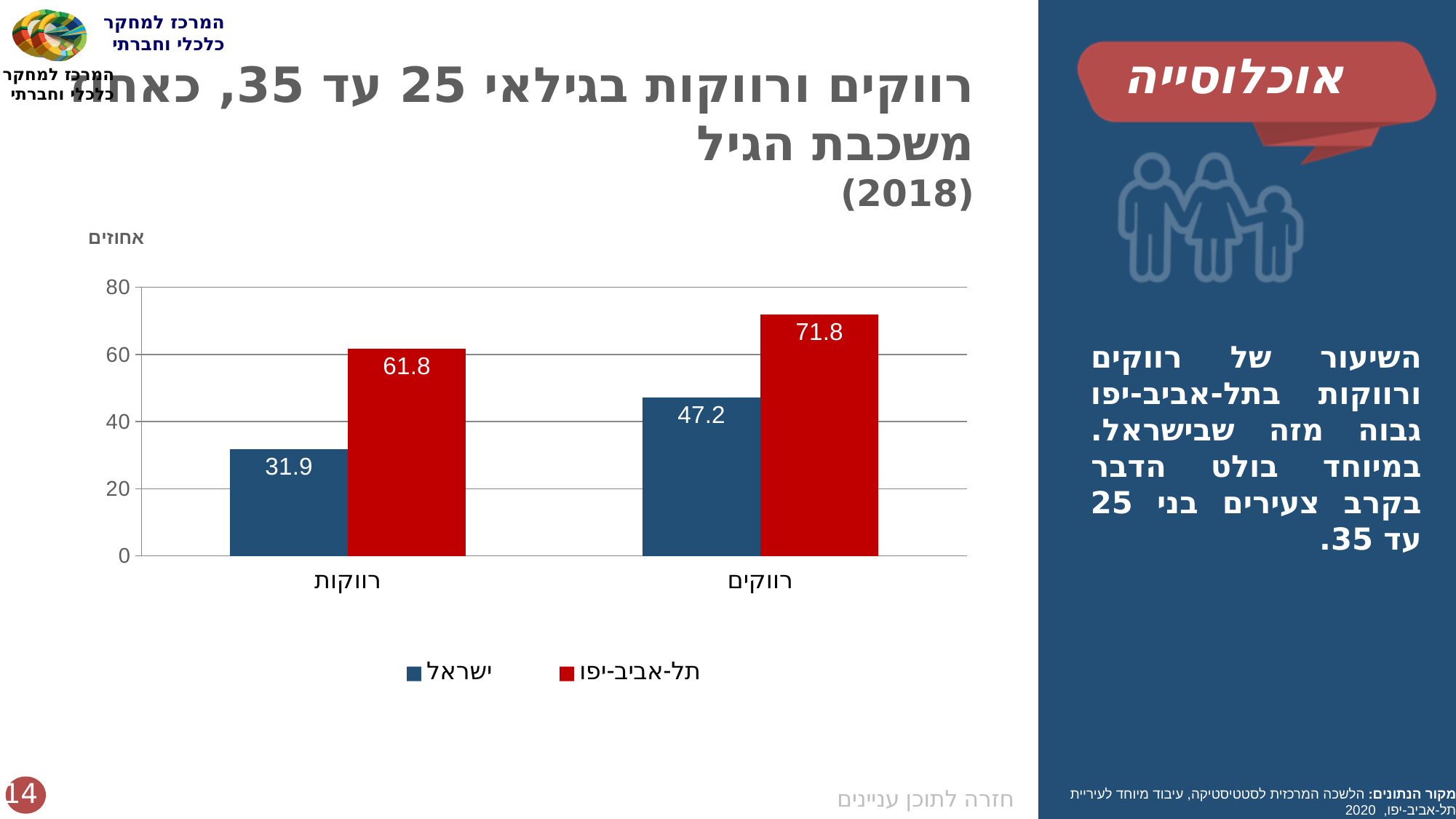
What kind of chart is shown on the slide? Bar chart How many series does the legend list? 2 What is the value for ישראל in the רווקות category? 31.9 What is the difference between the תל-אביב-יפו and ישראל values in the רווקים category? 24.6 Which is larger: the ישראל value for רווקים or the תל-אביב-יפו value for רווקות? תל-אביב-יפו value for רווקות What is the difference between the תל-אביב-יפו and ישראל values in the רווקות category? 29.9 Which bar has the lowest value on the chart? ישראל, רווקות What is the value for תל-אביב-יפו in the רווקות category? 61.8 What is the value for תל-אביב-יפו in the רווקים category? 71.8 How many categories are shown on the x axis? 2 Which bar has the highest value on the chart? תל-אביב-יפו, רווקים What is the value for ישראל in the רווקים category? 47.2